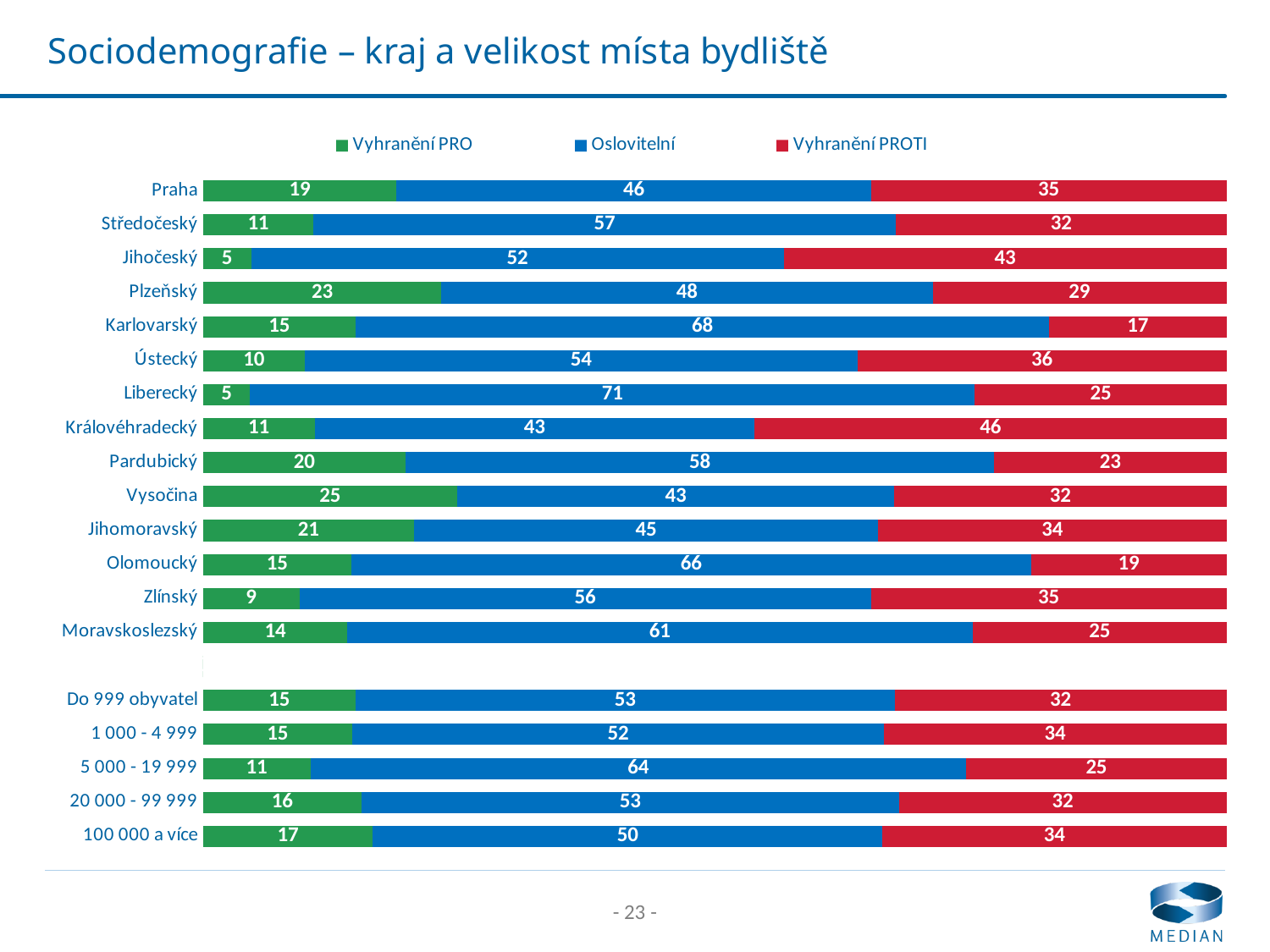
Which series is shown in red in the legend? Vyhranění PROTI What is the total of the stacked bar for Praha? 100 What is the Oslovitelní value for Liberecký? 71 Which is larger, the Vyhranění PRO value for Plzeňský or for Jihomoravský? Plzeňský Which category has the highest Vyhranění PRO value? Vysočina Which category has the highest Oslovitelní value? Liberecký What is the Vyhranění PRO value for 100 000 a více? 17 How many series does the legend list? 3 Which category has the lowest Vyhranění PROTI value? Karlovarský What is the difference between the Vyhranění PROTI values for Královéhradecký and Pardubický? 23 What is the Vyhranění PROTI value for Jihočeský? 43 What kind of chart is shown on the slide? Stacked bar chart